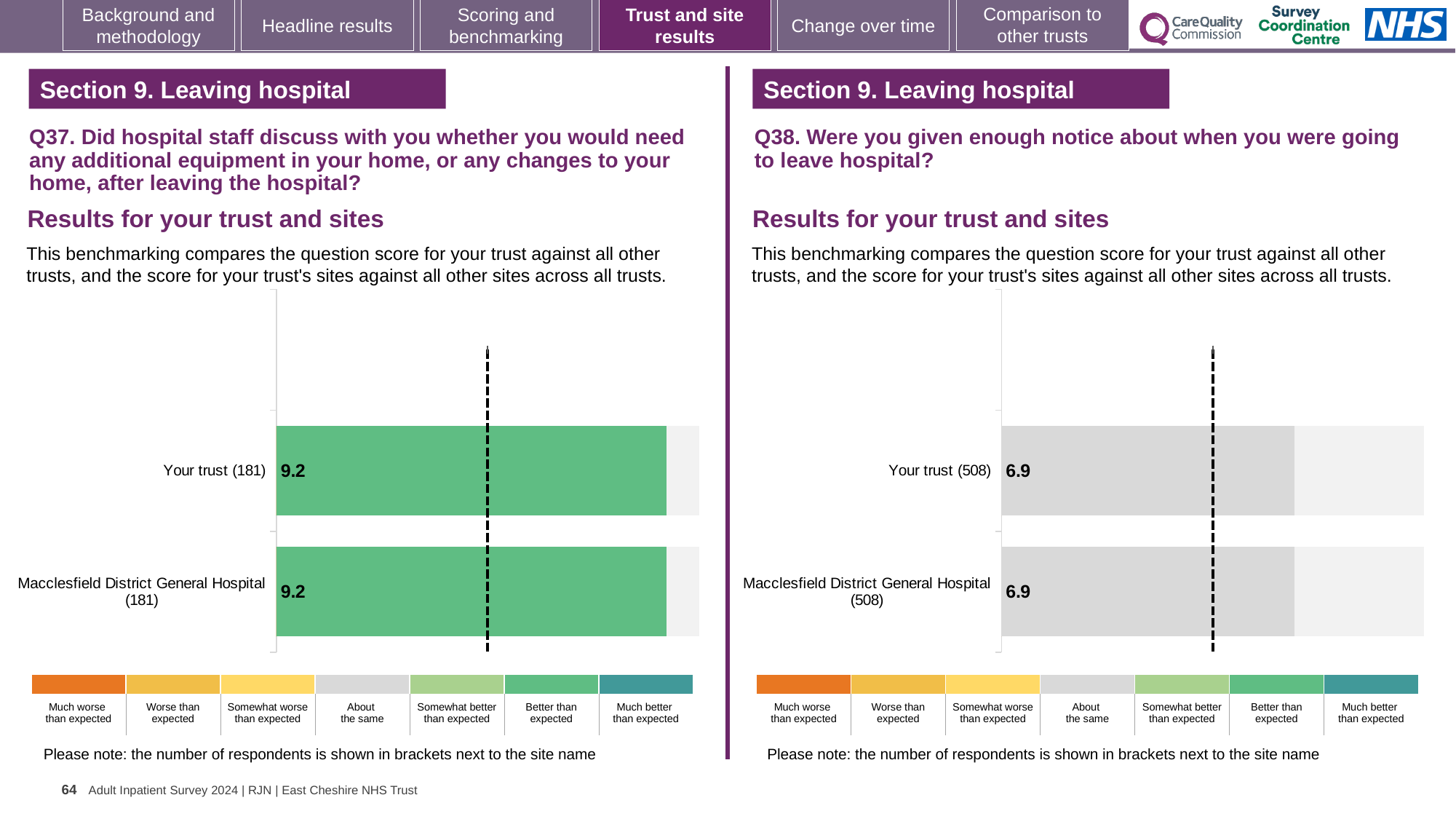
In the Q37 chart on the left, what is the score for Your trust? 9.2 In the Q37 chart on the left, what is the difference between the score for Your trust and the score for Macclesfield District General Hospital? 0.0 In the Q37 chart on the left, how many respondents are shown in brackets for Your trust? 181 In the Q38 chart on the right, what is the score for Macclesfield District General Hospital? 6.9 In the Q38 chart on the right, what is the difference between the score for Your trust and the score for Macclesfield District General Hospital? 0.0 In the Q38 chart on the right, what is the score for Your trust? 6.9 In the Q37 chart on the left, what is the score for Macclesfield District General Hospital? 9.2 Is the score for Your trust in the Q37 chart on the left larger or smaller than the score for Your trust in the Q38 chart on the right? Larger What kind of chart is used for Q37 on the left? Bar chart How many bars are plotted in the Q38 chart on the right? 2 How many bars are plotted in the Q37 chart on the left? 2 In the Q38 chart on the right, how many respondents are shown in brackets for Macclesfield District General Hospital? 508